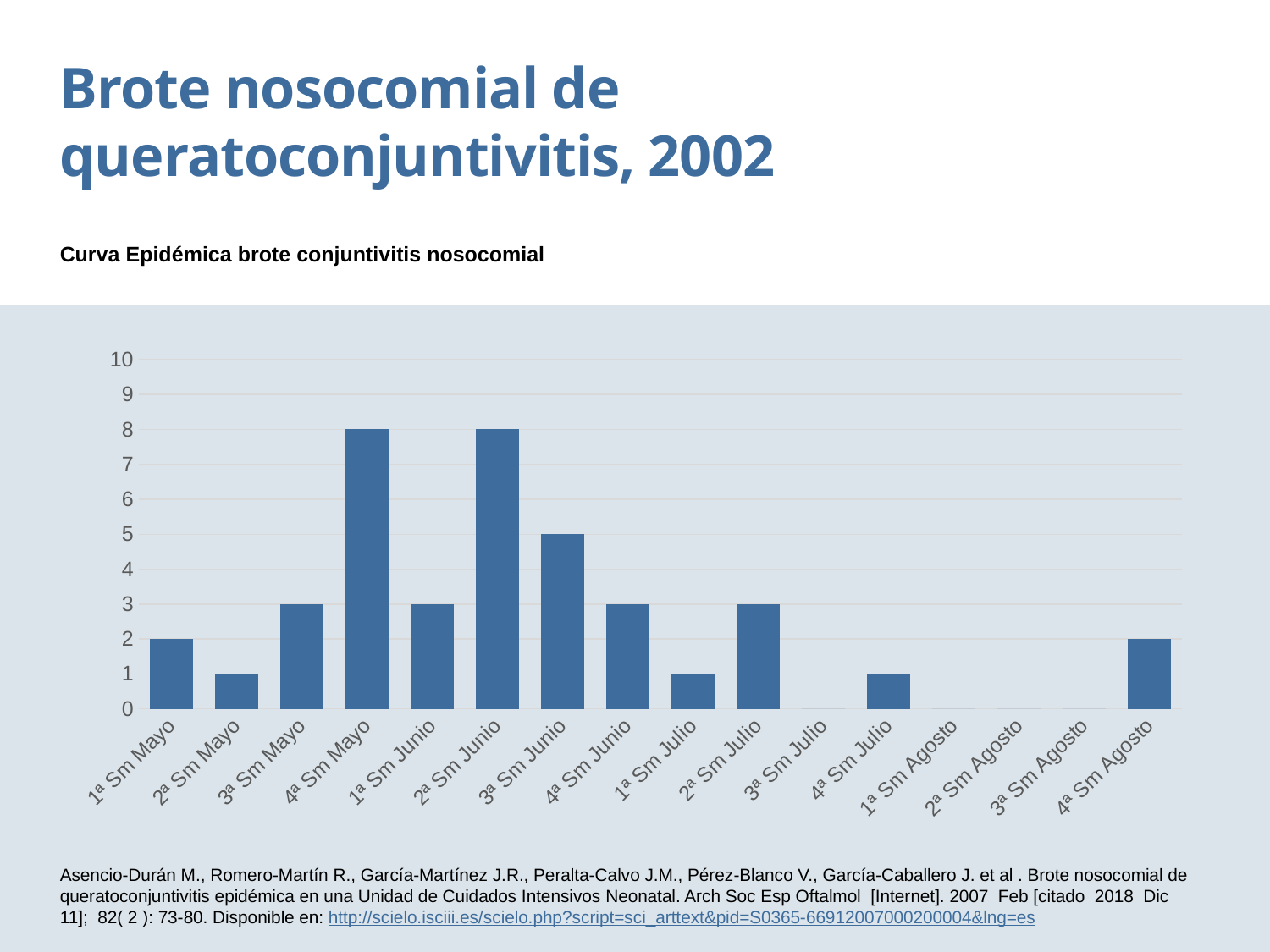
What is the title printed above the chart? Curva Epidémica brote conjuntivitis nosocomial What is the value for 1ª Sm Mayo? 2 What is the value for 4ª Sm Mayo? 8 How many weekly categories are shown on the x axis of the chart? 16 What kind of chart is shown on the slide? bar chart Which is larger, the value for 3ª Sm Mayo or the value for 2ª Sm Mayo? 3ª Sm Mayo What is the difference between the values for 4ª Sm Junio and 1ª Sm Julio? 2 What is the value for 3ª Sm Junio? 5 Is the value for 4ª Sm Mayo greater or less than 5? greater What is the difference between the values for 2ª Sm Junio and 3ª Sm Junio? 3 What is the highest value reached by any bar in the chart? 8 What is the value for 4ª Sm Agosto? 2